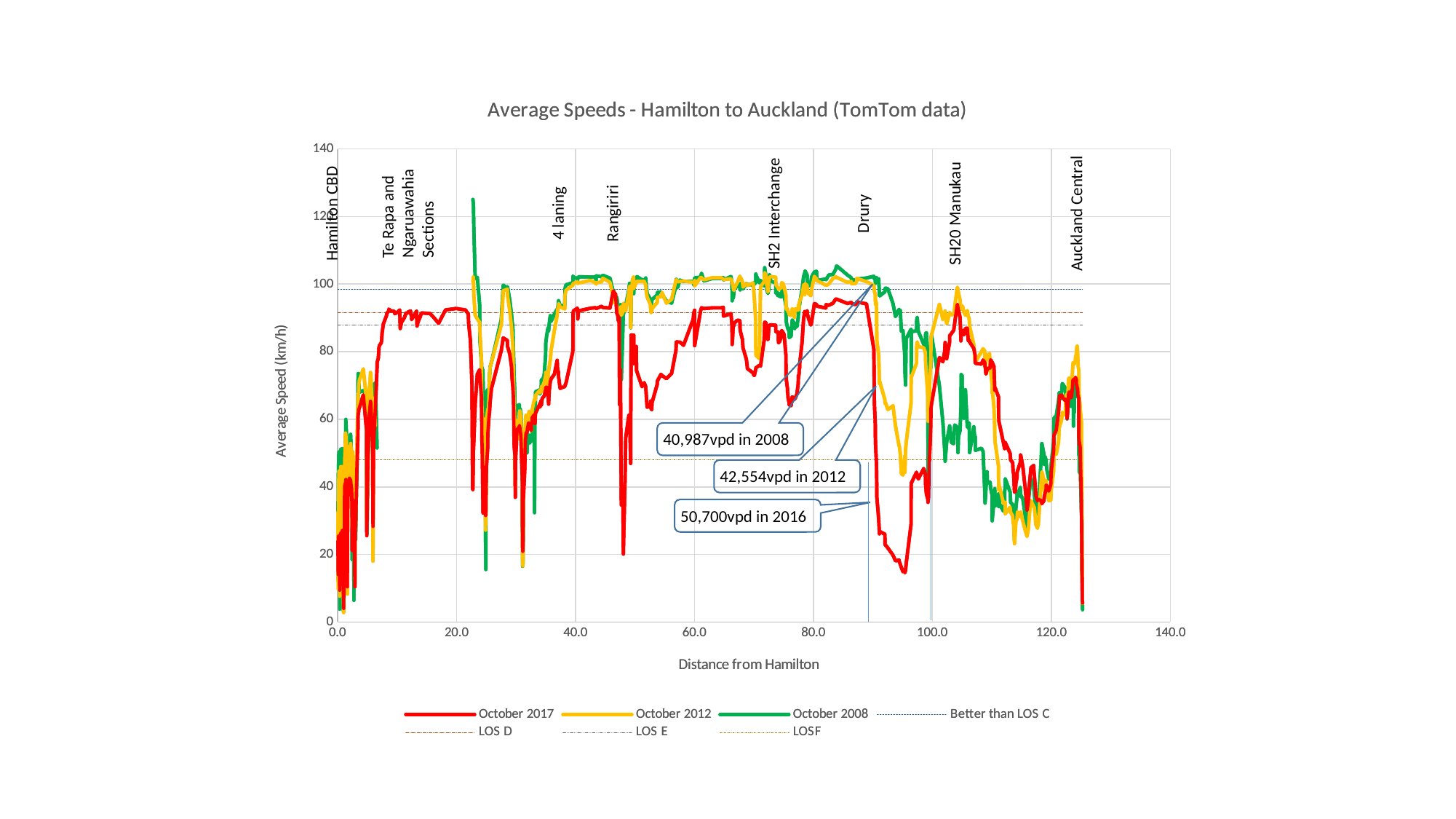
Is the October 2017 average speed at about 95 km from Hamilton greater or less than 40? less Which series is drawn in red on the chart? October 2017 According to the annotation on the chart, what was the traffic volume in 2012? 42,554vpd Is the October 2008 average speed at about 60 km from Hamilton greater or less than 80? greater What is the title of the chart? Average Speeds - Hamilton to Auckland (TomTom data) Is the October 2012 average speed at about 40 km from Hamilton greater or less than 80? greater Between about 90 km and 95 km from Hamilton, does the October 2017 line rise or fall? fall How many entries does the chart legend list? 7 According to the annotation on the chart, what was the traffic volume in 2008? 40,987vpd What kind of chart is shown on the slide? line chart According to the annotation on the chart, what was the traffic volume in 2016? 50,700vpd At about 95 km from Hamilton, which series shows the higher average speed, October 2008 or October 2017? October 2008